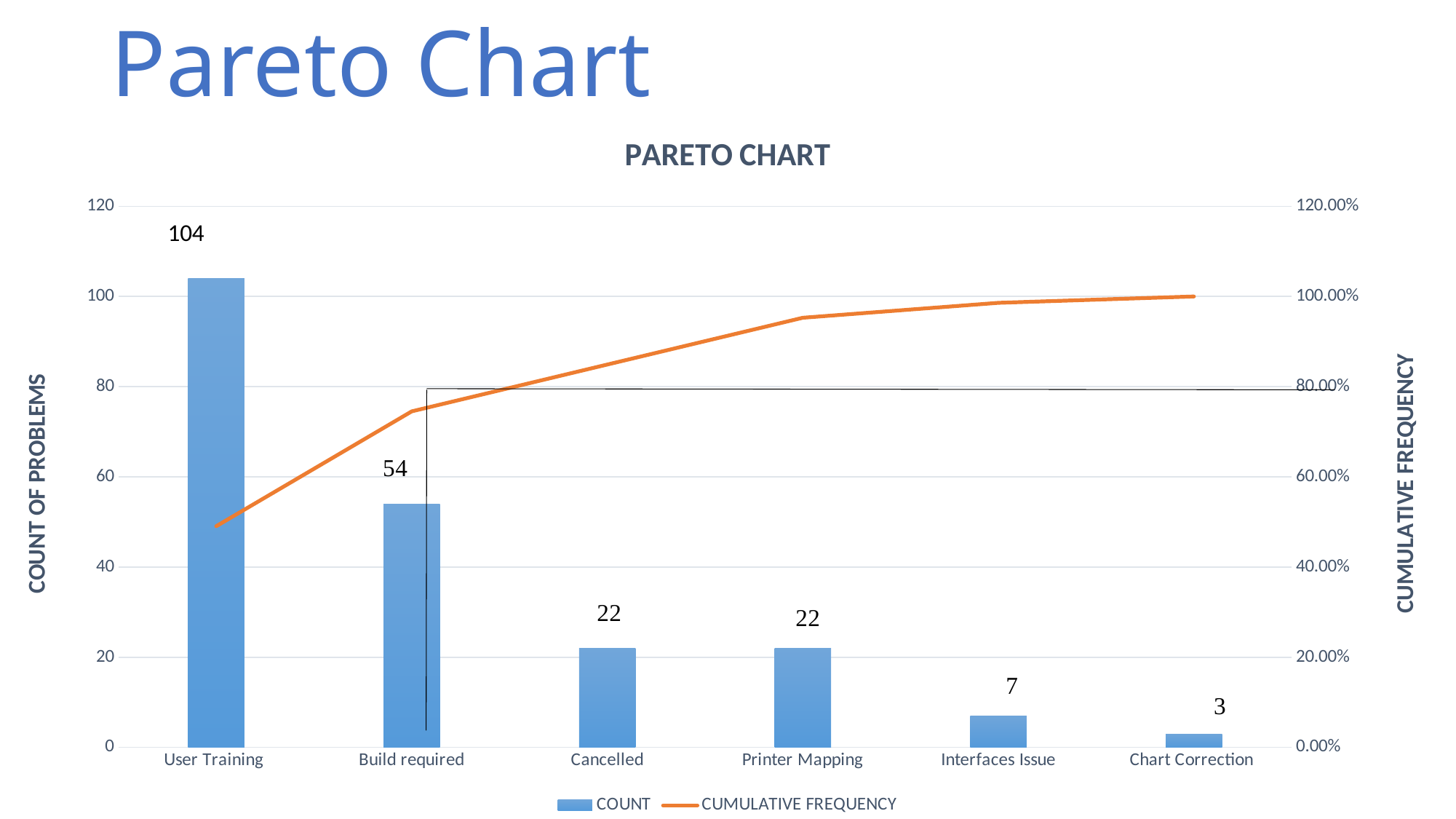
Which has a larger COUNT, Build required or Cancelled? Build required Which category has the highest COUNT? User Training What is the COUNT value for User Training? 104 What is the COUNT value for Build required? 54 What is the difference between the COUNT for User Training and the COUNT for Build required? 50 How many series does the legend list? 2 What is the COUNT value for Chart Correction? 3 What is the COUNT value for Interfaces Issue? 7 What is the title of the chart? PARETO CHART Is the CUMULATIVE FREQUENCY value for Build required greater or less than 80.00%? less How many categories are shown on the x axis? 6 Which category has the lowest COUNT? Chart Correction